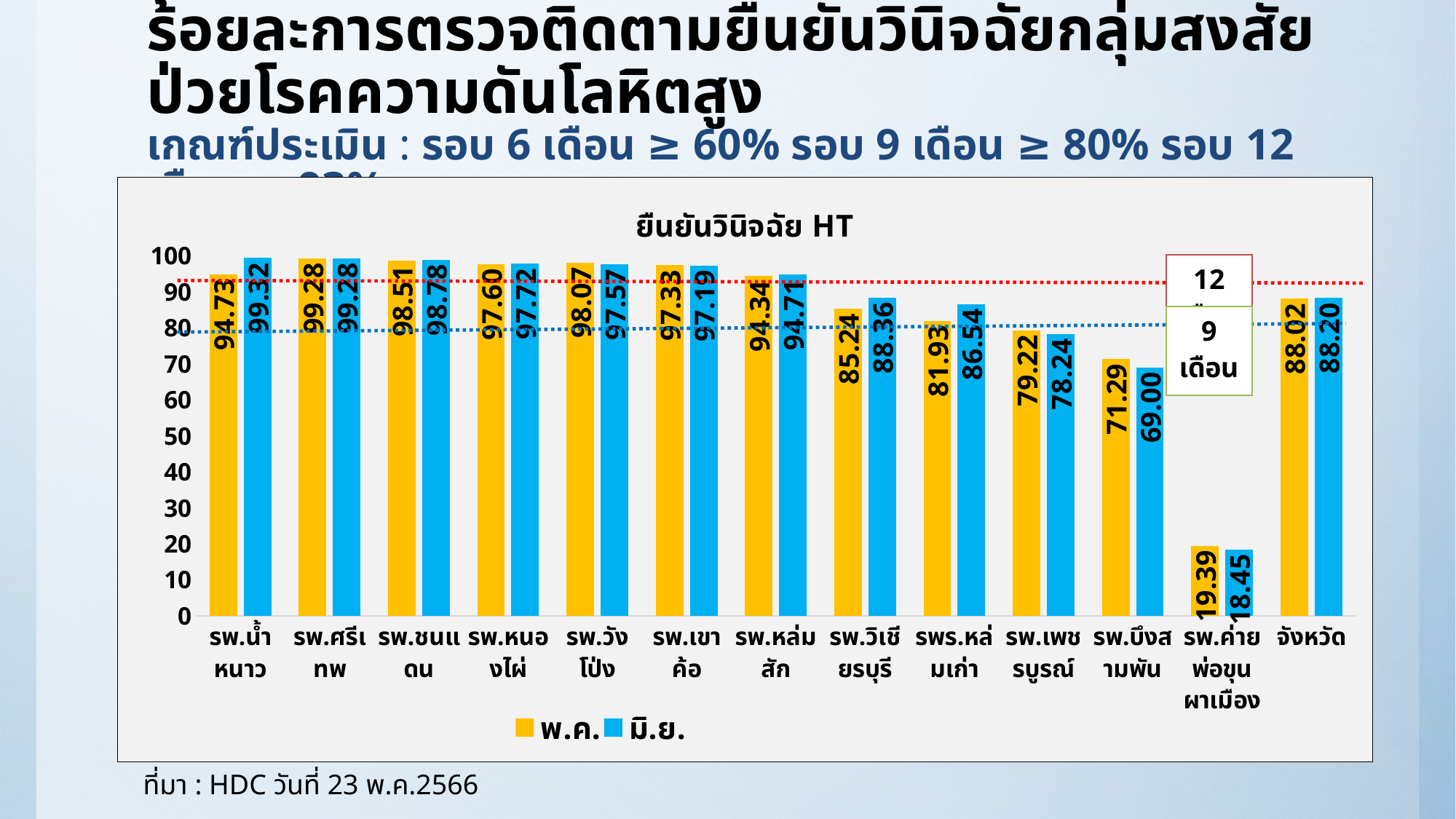
How many series does the legend list? 2 What is the value for จังหวัด in the มิ.ย. series? 88.20 What is the value for รพ.น้ำหนาว in the มิ.ย. series? 99.32 What is the difference between the มิ.ย. and พ.ค. values for รพร.หล่มเก่า? 4.61 For รพ.เพชรบูรณ์, which series has the larger value, พ.ค. or มิ.ย.? พ.ค. Which category has the highest value in the มิ.ย. series? รพ.น้ำหนาว Which category has the lowest value in the พ.ค. series? รพ.ค่ายพ่อขุนผาเมือง What is the value for รพ.บึงสามพัน in the พ.ค. series? 71.29 Is the มิ.ย. value for รพ.วิเชียรบุรี greater or less than 80? greater What is the title of the chart? ยืนยันวินิจฉัย HT What type of chart is shown on the slide? bar chart How many categories are shown on the x axis? 13